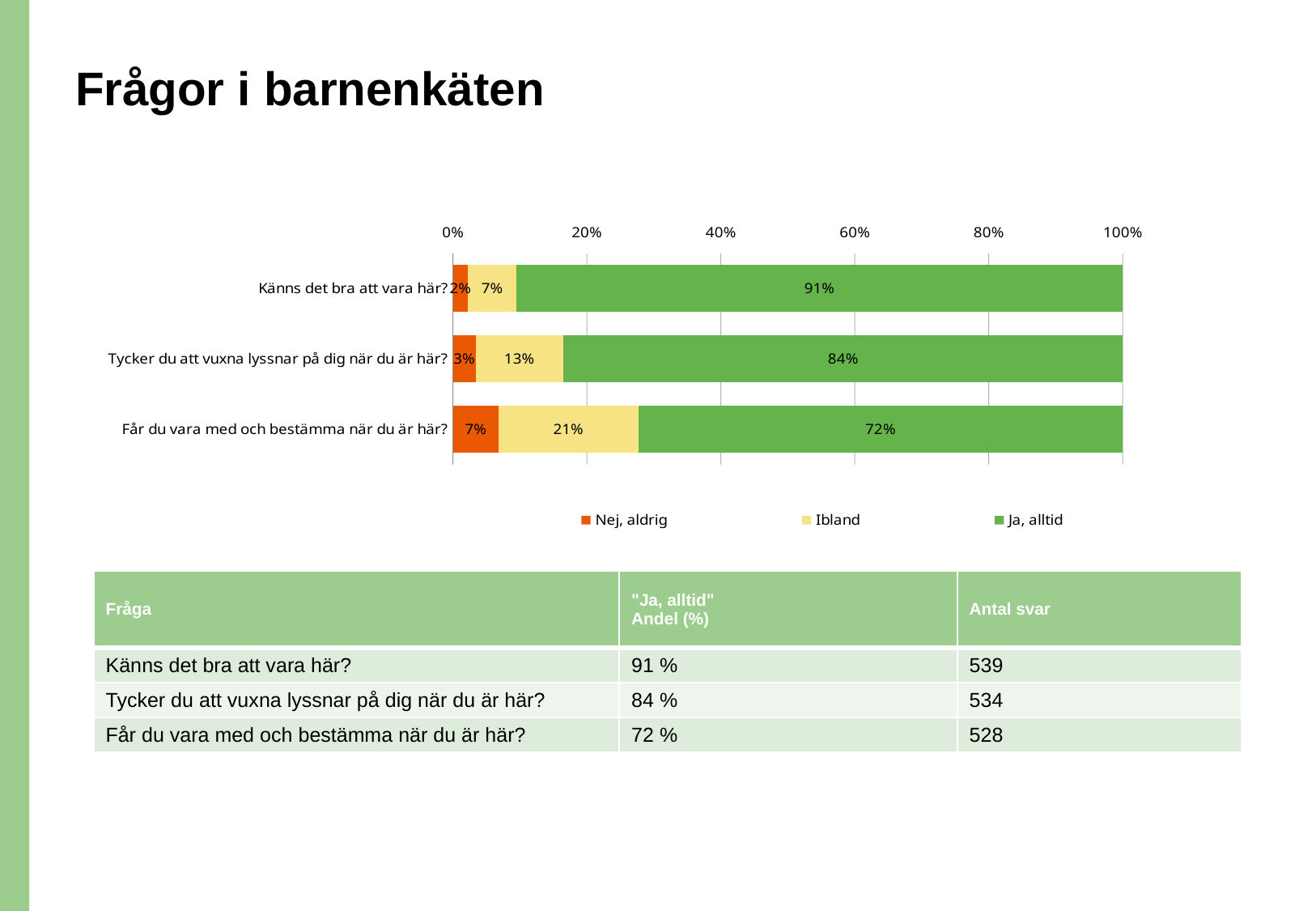
What is the "Nej, aldrig" value for "Får du vara med och bestämma när du är här?"? 7% What kind of chart is shown on the slide? Stacked bar chart How many series does the legend list? 3 What is the "Ibland" value for "Tycker du att vuxna lyssnar på dig när du är här?"? 13% What is the total of the stacked bar for "Tycker du att vuxna lyssnar på dig när du är här?"? 100% Which question has the highest "Ja, alltid" share? Känns det bra att vara här? Which series is shown in green in the chart? Ja, alltid Which question has the lowest "Ja, alltid" share? Får du vara med och bestämma när du är här? Which is larger: the "Ibland" value for "Får du vara med och bestämma när du är här?" or for "Tycker du att vuxna lyssnar på dig när du är här?"? Får du vara med och bestämma när du är här? How many questions (categories) are shown in the chart? 3 What is the "Ja, alltid" value for "Känns det bra att vara här?"? 91% What is the difference between the "Ja, alltid" values for "Känns det bra att vara här?" and "Får du vara med och bestämma när du är här?"? 19%